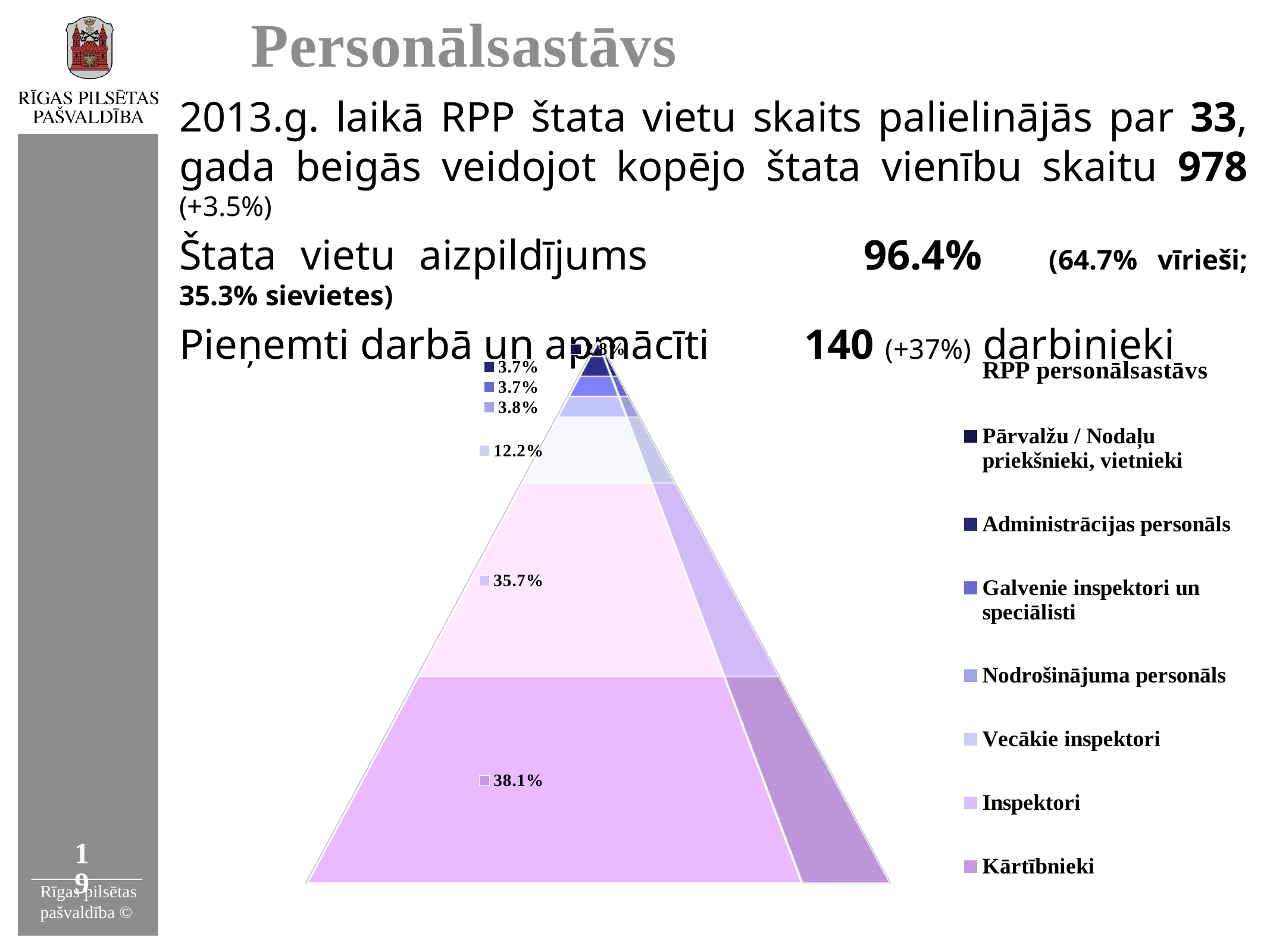
In the RPP personālsastāvs chart, what percentage is shown for Inspektori? 35.7% In the RPP personālsastāvs chart, what is the difference between the shares of Inspektori and Vecākie inspektori? 23.5% In the RPP personālsastāvs chart, what percentage is shown for Nodrošinājuma personāls? 3.8% In the RPP personālsastāvs chart, which has a larger share: Inspektori or Vecākie inspektori? Inspektori In the RPP personālsastāvs chart, what is the combined share of Kārtībnieki and Inspektori? 73.8% How many groups does the legend of the RPP personālsastāvs chart list? 7 In the RPP personālsastāvs chart, what percentage is shown for Administrācijas personāls? 3.7% In the RPP personālsastāvs chart, which group has the largest share? Kārtībnieki In the RPP personālsastāvs chart, what is the difference between the shares of Kārtībnieki and Inspektori? 2.4% What kind of chart is used to show the RPP personālsastāvs data? pyramid chart In the RPP personālsastāvs chart, what percentage is shown for Vecākie inspektori? 12.2% In the RPP personālsastāvs chart, what percentage is shown for Kārtībnieki? 38.1%